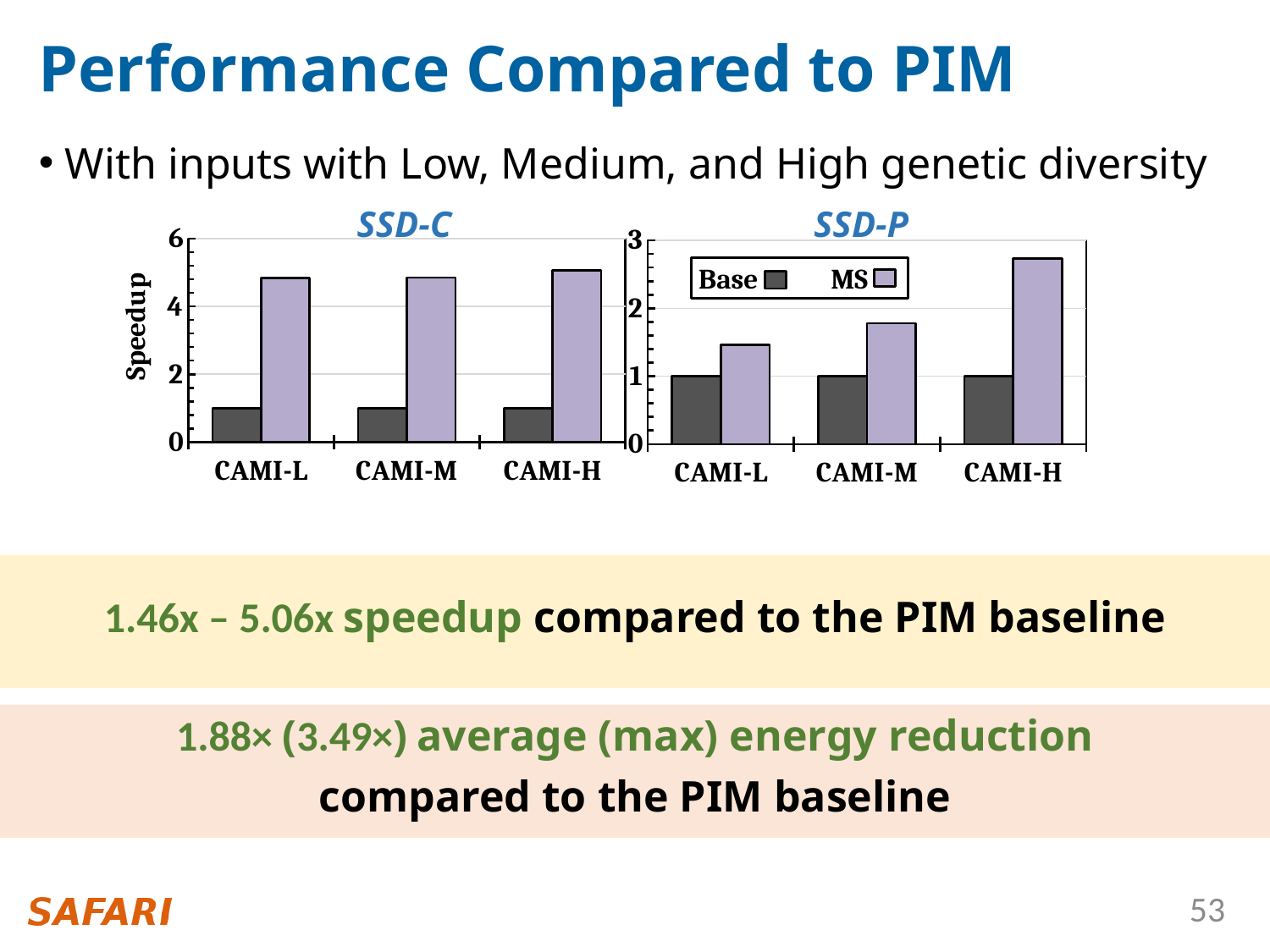
In the SSD-P chart, do the MS values rise or fall from CAMI-L to CAMI-H? rise In the SSD-C chart, for CAMI-M, which is larger: the Base value or the MS value? MS In the SSD-C chart, is the MS value for CAMI-L greater or less than 4? greater How many categories are shown on the x axis of the SSD-P chart? 3 What kind of chart is the SSD-C chart? bar chart How many series does the legend list for the charts? 2 In the SSD-P chart, is the MS value for CAMI-H greater or less than 2? greater In the SSD-P chart, which category has the lowest MS value? CAMI-L In the SSD-P chart, is the MS value for CAMI-L greater or less than 2? less In the SSD-P chart, which category has the highest MS value? CAMI-H In the SSD-P chart, what is the Base value for CAMI-H? 1